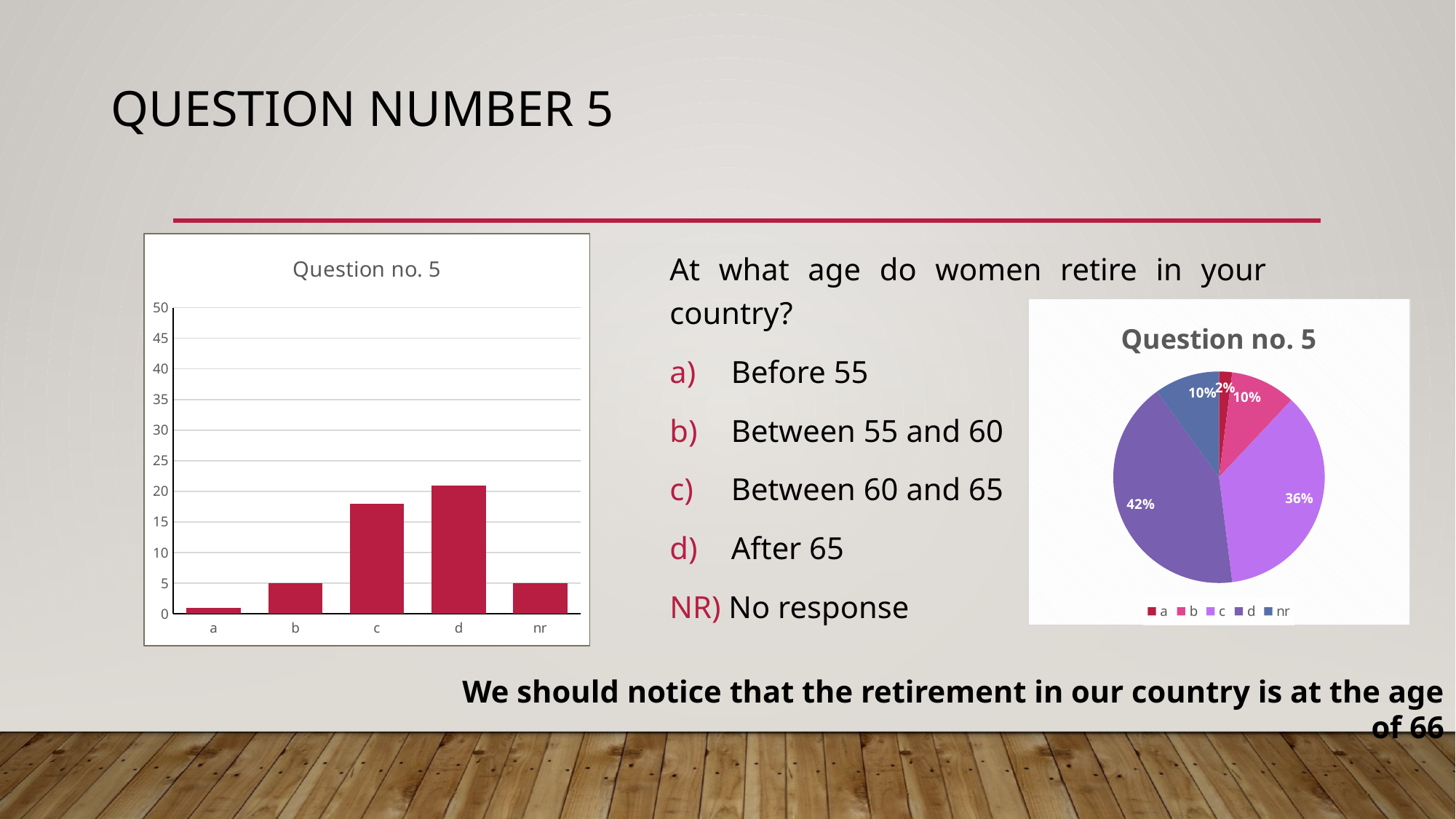
In the pie chart on the right, what share does d have? 42% In the bar chart on the left, which category has the highest bar? d In the bar chart on the left, is the value for d greater or less than 25? less In the bar chart on the left, is the value for c greater or less than 15? greater In the bar chart on the left, what is the value for b? 5 What kind of chart is the chart on the right of the slide? pie chart What kind of chart is the chart on the left of the slide? bar chart In the bar chart on the left, which category has the lowest bar? a In the pie chart on the right, what share does c have? 36% How many categories are shown on the x axis of the bar chart on the left? 5 In the pie chart on the right, what is the difference between the shares of d and c? 6% How many entries does the legend of the pie chart on the right list? 5